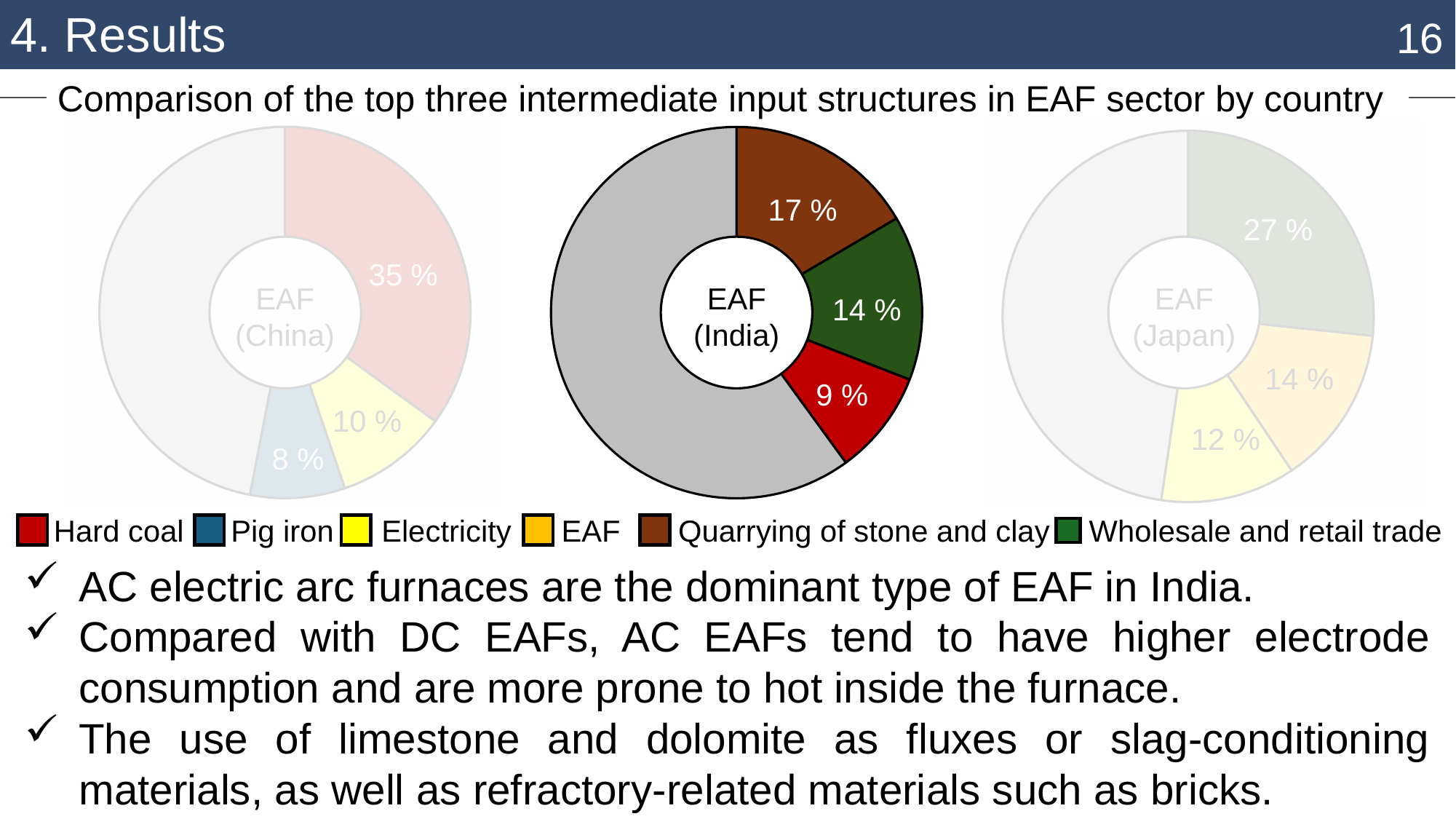
In the EAF (India) chart, which labelled input has the smallest share? Hard coal In the EAF (India) chart, what share is shown for Quarrying of stone and clay? 17 % How many entries does the legend list? 6 How many charts are shown on the slide? 3 In the EAF (India) chart, which labelled input has the largest share? Quarrying of stone and clay In the EAF (India) chart, what is the difference between the Quarrying of stone and clay share and the Hard coal share? 8 % In the EAF (Japan) chart, what share is shown for Wholesale and retail trade? 27 % What kind of chart is used for EAF (India)? Pie (donut) chart In the EAF (India) chart, is the share for Wholesale and retail trade larger or smaller than the share for Hard coal? larger In the EAF (India) chart, what share is shown for Wholesale and retail trade? 14 % In the EAF (China) chart, what share is shown for Hard coal? 35 % In the EAF (India) chart, what share is shown for Hard coal? 9 %